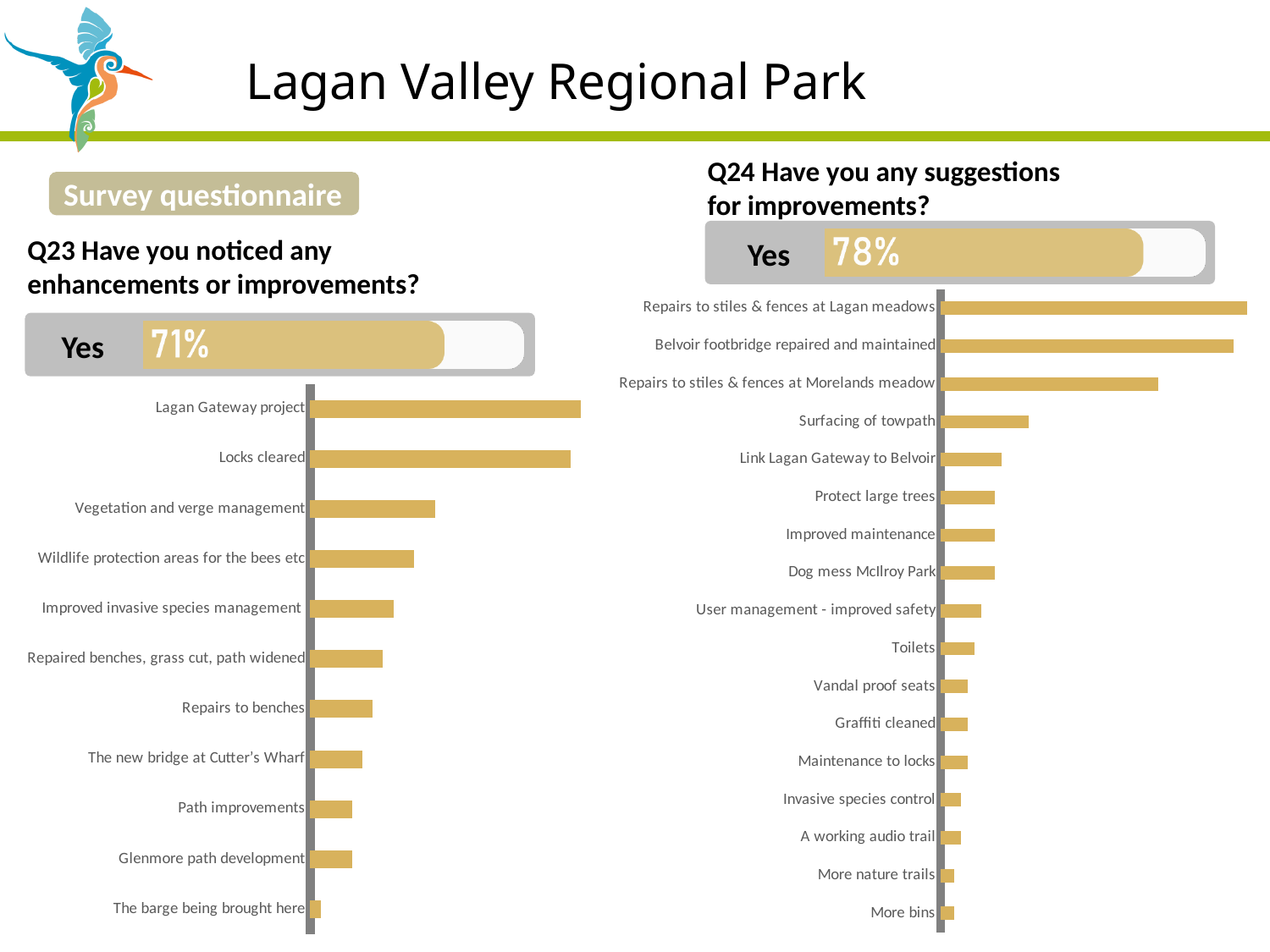
What colour are the bars in the Q24 chart on the right? gold In the Q24 chart on the right, which has the larger value: Surfacing of towpath or Toilets? Surfacing of towpath How many categories are plotted in the Q24 chart on the right? 17 What kind of chart is shown under Q23 on the left of the slide? bar chart What percentage answered Yes to Q23 on the left of the slide? 71% In the Q24 chart on the right, which has the larger value: Repairs to stiles & fences at Morelands meadow or Surfacing of towpath? Repairs to stiles & fences at Morelands meadow In the Q23 chart on the left, which category has the shortest bar? The barge being brought here How many categories are plotted in the Q23 chart on the left? 11 In the Q23 chart on the left, which has the larger value: Vegetation and verge management or Repairs to benches? Vegetation and verge management What percentage answered Yes to Q24 on the right of the slide? 78% In the Q23 chart on the left, which category has the longest bar? Lagan Gateway project